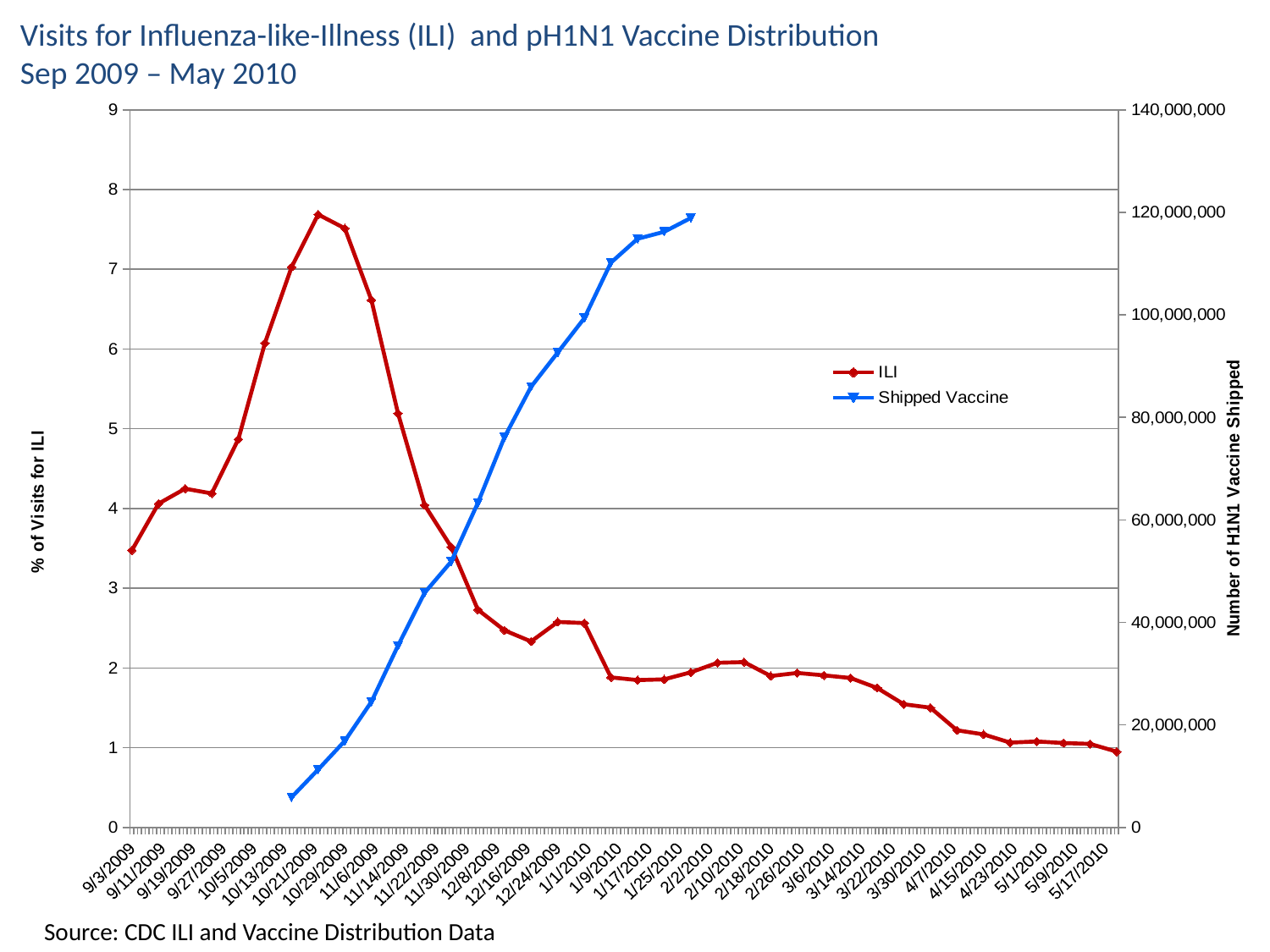
Is the Shipped Vaccine value for 2/2/2010 greater or less than 100,000,000? greater Is the ILI value for 9/3/2009 greater or less than 3? greater On which date does the ILI series reach its highest value? 10/21/2009 Which is larger, the ILI value for 9/3/2009 or the ILI value for 5/17/2010? 9/3/2009 What kind of chart is shown on the slide? line chart Is the Shipped Vaccine value for 10/13/2009 greater or less than 20,000,000? less Does the Shipped Vaccine series rise or fall from 10/13/2009 to 2/2/2010? rise What is the title of the left vertical axis? % of Visits for ILI What are the two series named in the legend? ILI and Shipped Vaccine On which date does the ILI series reach its lowest value? 5/17/2010 How many series does the legend list? 2